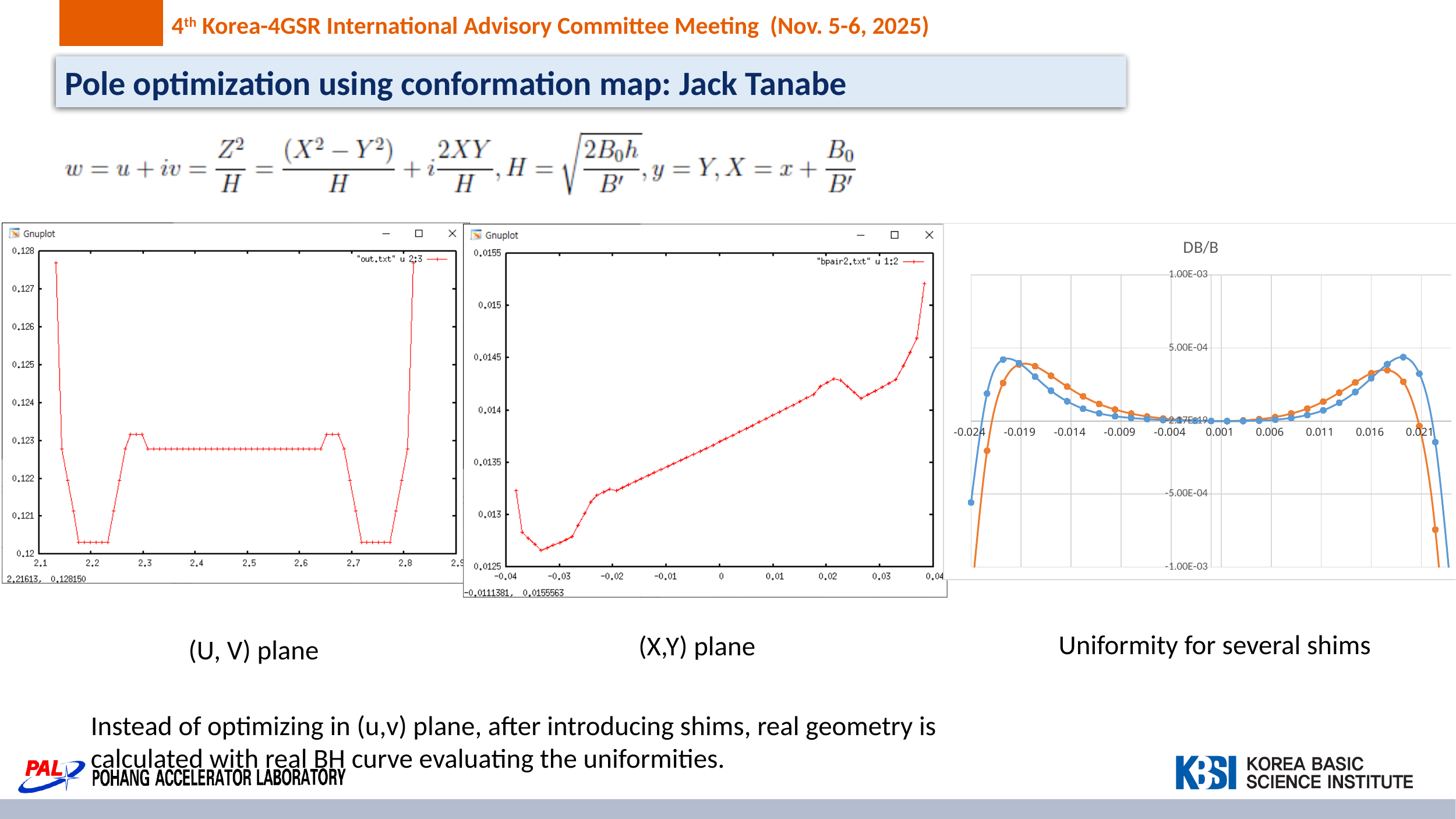
In the (X,Y) plane chart, do the values rise or fall along the x axis between x = -0.02 and x = 0.02? rise In the DB/B chart, is the peak value of the blue series near x = -0.019 greater or less than 5.00E-04? less In the (X,Y) plane chart, is the value at x = 0.03 greater or less than 0.014? greater What is the title shown above the rightmost chart? DB/B In the (X,Y) plane chart, is the value at x = 0 greater or less than 0.0135? greater In the (U, V) plane chart, what data file name is shown in the legend? "out.txt" u 2:3 What kind of chart is the (U, V) plane chart? line chart What kind of chart is the DB/B chart (Uniformity for several shims)? line chart In the DB/B chart, how many data series (lines) are plotted? 2